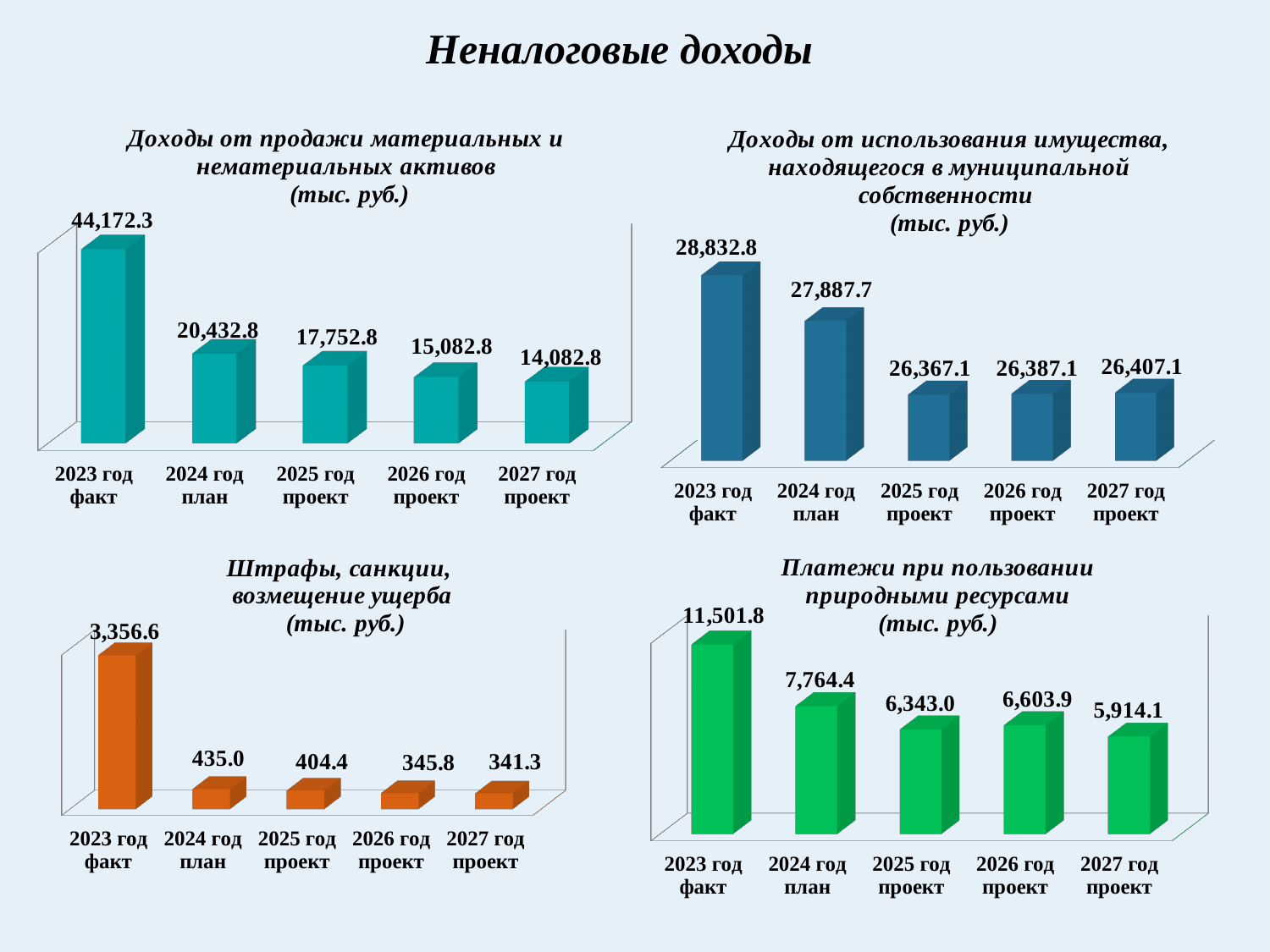
In the top-right chart (Доходы от использования имущества), what is the value for 2025 год проект? 26,367.1 In the bottom-right chart (Платежи при пользовании природными ресурсами), which is larger: the value for 2025 год проект or 2026 год проект? 2026 год проект In the bottom-right chart (Платежи при пользовании природными ресурсами), what is the value for 2024 год план? 7,764.4 In the bottom-right chart (Платежи при пользовании природными ресурсами), which category has the lowest value? 2027 год проект How many categories are shown in the bottom-left chart (Штрафы, санкции, возмещение ущерба)? 5 In the bottom-left chart (Штрафы, санкции, возмещение ущерба), what is the value for 2027 год проект? 341.3 In the top-left chart (Доходы от продажи материальных и нематериальных активов), what is the value for 2023 год факт? 44,172.3 In the top-left chart (Доходы от продажи материальных и нематериальных активов), what is the difference between the values for 2023 год факт and 2024 год план? 23,739.5 In the top-left chart (Доходы от продажи материальных и нематериальных активов), do the values rise or fall from 2023 год факт to 2027 год проект? Fall What kind of chart is the top-left chart (Доходы от продажи материальных и нематериальных активов)? Bar chart In the bottom-right chart (Платежи при пользовании природными ресурсами), what is the difference between the values for 2026 год проект and 2025 год проект? 260.9 In the top-right chart (Доходы от использования имущества), which category has the highest value? 2023 год факт